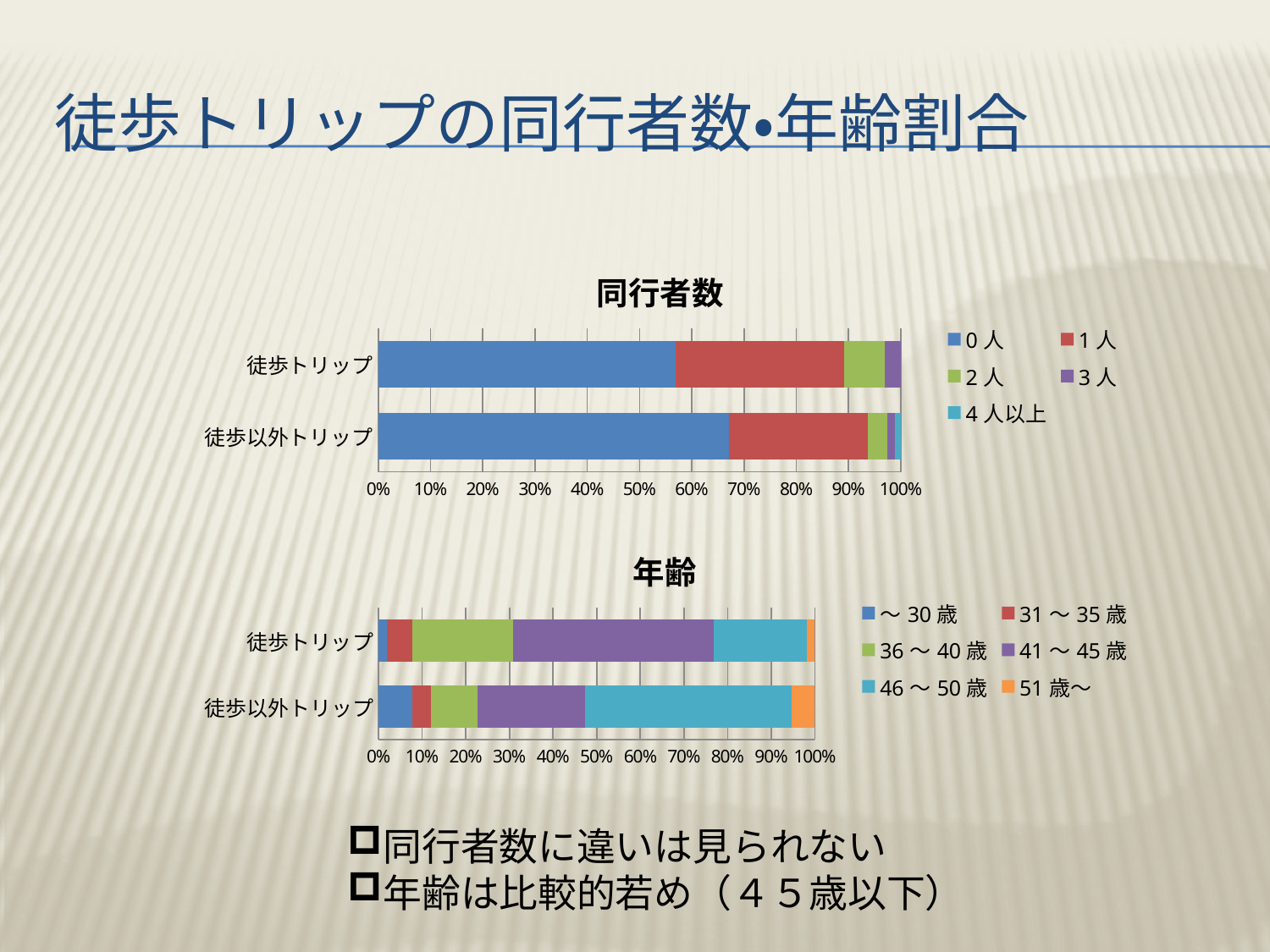
What kind of chart is the 同行者数 chart? stacked bar chart In the 同行者数 chart, which category has the larger 0人 share, 徒歩トリップ or 徒歩以外トリップ? 徒歩以外トリップ How many series does the legend of the 年齢 chart list? 6 In the 年齢 chart, which age group is the largest segment for 徒歩トリップ? 41～45歳 In the 同行者数 chart, is the 0人 share for 徒歩トリップ greater or less than 60%? less In the 年齢 chart, which category has the larger 36～40歳 share, 徒歩トリップ or 徒歩以外トリップ? 徒歩トリップ How many categories are shown on the 年齢 chart? 2 What is the title of the lower chart on the slide? 年齢 In the 年齢 chart, which age group is the largest segment for 徒歩以外トリップ? 46～50歳 In the 年齢 chart, is the 46～50歳 share for 徒歩以外トリップ greater or less than 40%? greater How many series does the legend of the 同行者数 chart list? 5 In the 同行者数 chart, is the 0人 share for 徒歩以外トリップ greater or less than 60%? greater